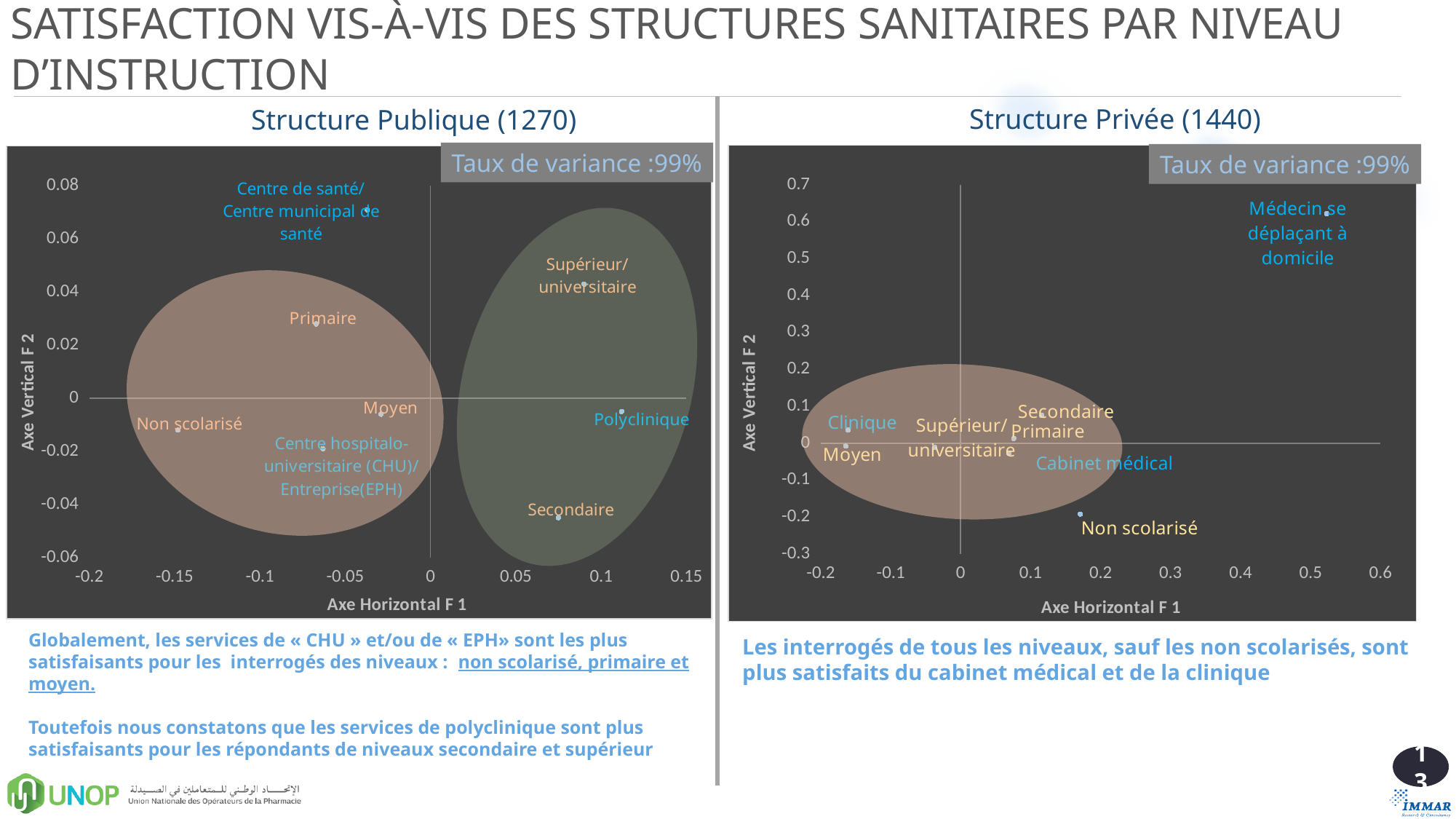
In the 'Structure Privée (1440)' chart, which labelled point is lowest on the Axe Vertical F 2? Non scolarisé In the 'Structure Privée (1440)' chart, which labelled point is highest on the Axe Vertical F 2? Médecin se déplaçant à domicile In the 'Structure Privée (1440)' chart, is the Axe Vertical F 2 value for Non scolarisé greater or less than -0.1? less What kind of chart is shown under 'Structure Publique (1270)'? scatter chart In the 'Structure Publique (1270)' chart, is the Axe Horizontal F 1 value for Polyclinique greater or less than 0.05? greater In the 'Structure Publique (1270)' chart, is the Axe Vertical F 2 value for Secondaire greater or less than 0? less In the 'Structure Publique (1270)' chart, which labelled point is lowest on the Axe Vertical F 2? Secondaire In the 'Structure Publique (1270)' chart, which labelled point is furthest left on the Axe Horizontal F 1? Non scolarisé What 'Taux de variance' is shown on the 'Structure Privée (1440)' chart? 99% In the 'Structure Publique (1270)' chart, which labelled point is highest on the Axe Vertical F 2? Centre de santé/Centre municipal de santé